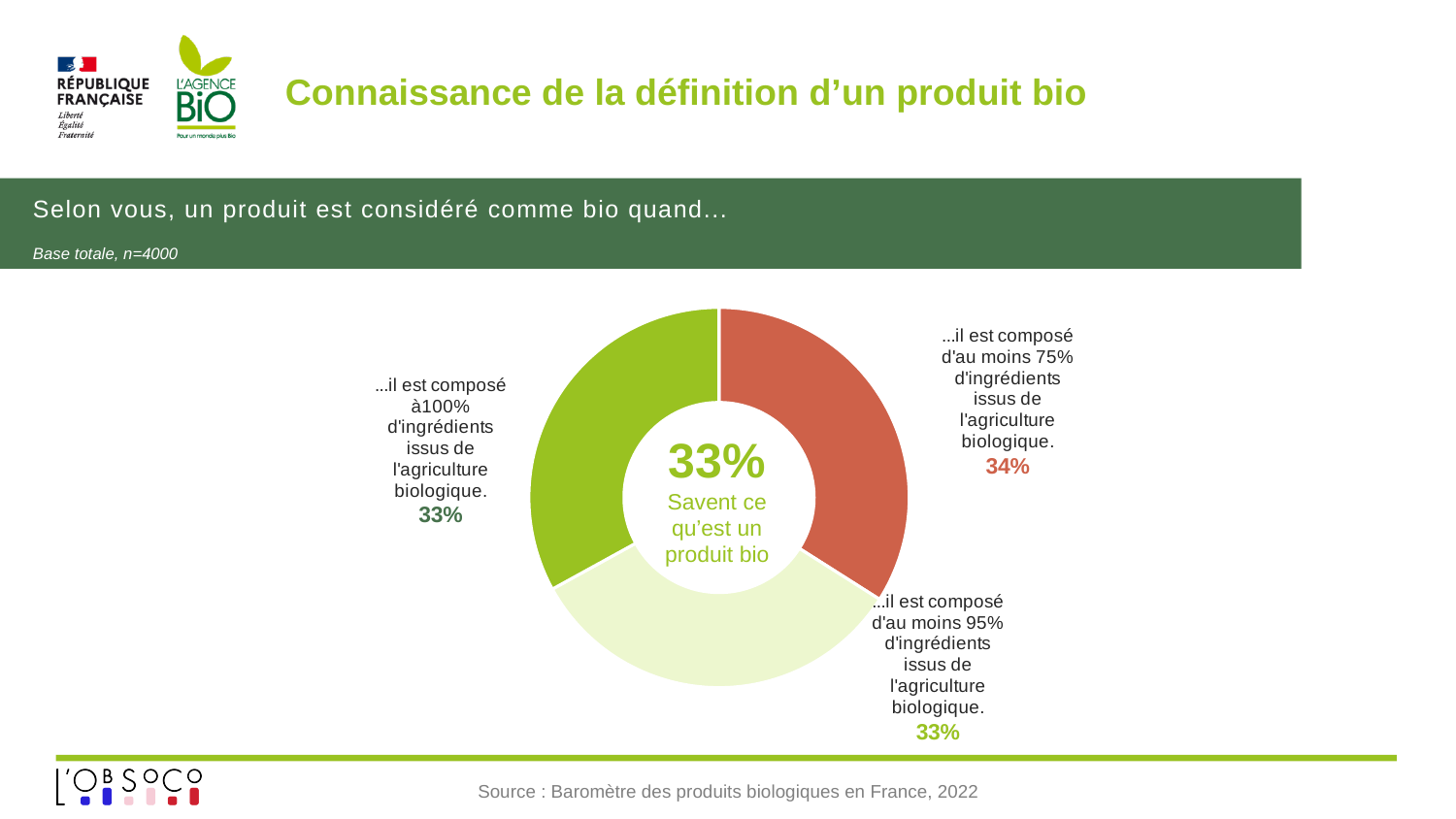
What percentage of respondents say a product is organic when it is composed of at least 75% organic ingredients? 34% What is the total of the three slices shown in the chart? 100% What percentage is displayed in the centre of the donut chart? 33% What is the difference in percentage points between the 'au moins 75%' slice and the 'au moins 95%' slice? 1 percentage point Which answer option has the highest share in the chart? ...il est composé d'au moins 75% d'ingrédients issus de l'agriculture biologique. Is the share for 'au moins 75%' larger or smaller than the share for '100%'? larger What type of chart is shown on the slide? Donut (pie) chart What is the sample size indicated under the question on the slide? n=4000 How many answer categories are shown in the chart? 3 What percentage of respondents say a product is organic when it is composed of 100% organic ingredients? 33% What percentage of respondents say a product is organic when it is composed of at least 95% organic ingredients? 33%